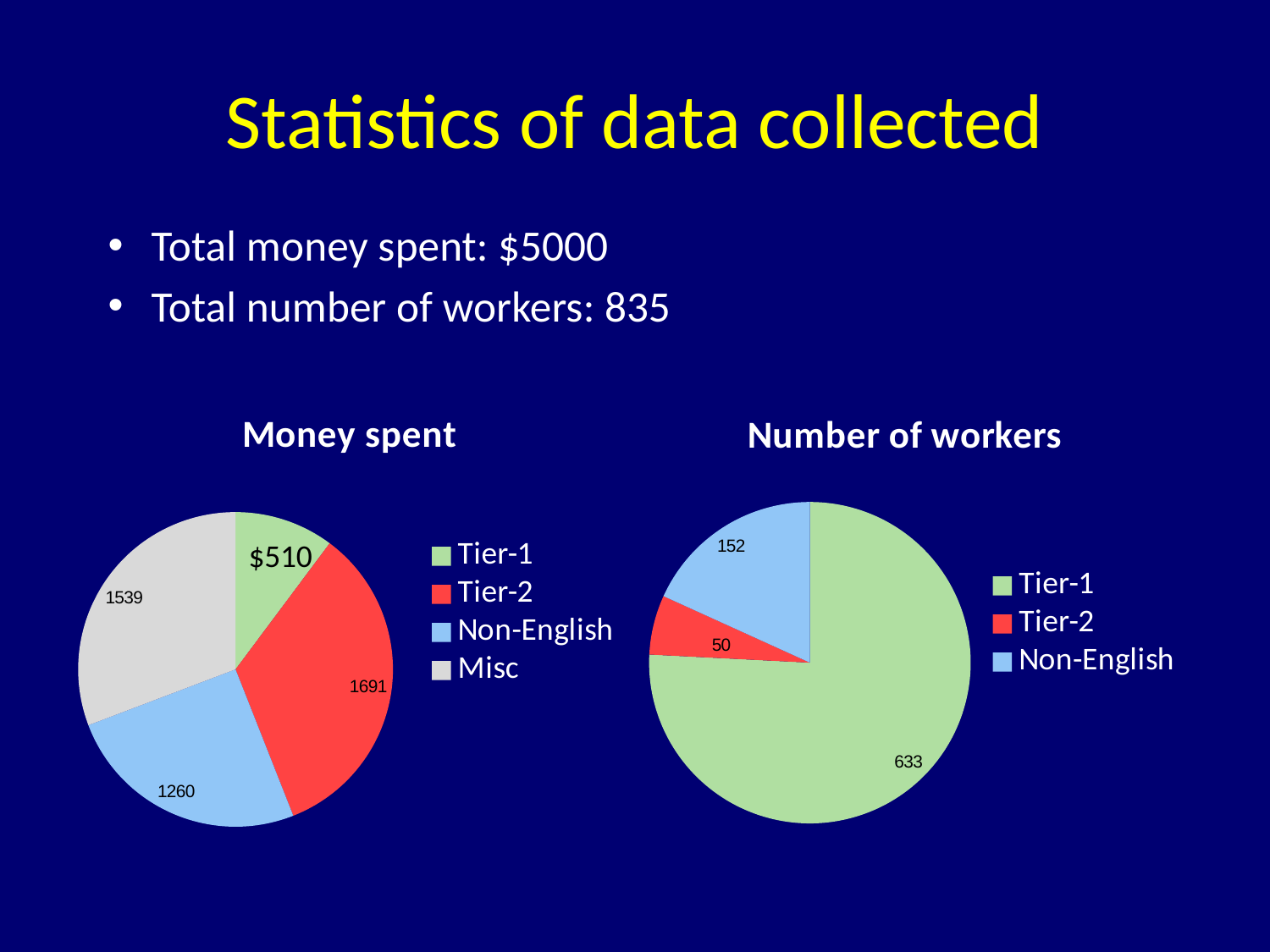
In the Money spent chart, what is the difference between Misc and Non-English? 279 In the Money spent chart, what is the value for Tier-1? $510 In the Number of workers chart, what is the value for Tier-2? 50 In the Money spent chart, what is the value for Tier-2? 1691 In the Money spent chart, which category has the smallest slice? Tier-1 What kind of chart is the Number of workers chart? Pie chart In the Money spent chart, which is larger, Misc or Non-English? Misc How many slices does the Money spent chart have? 4 In the Money spent chart, which category has the largest slice? Tier-2 In the Number of workers chart, which category has the largest slice? Tier-1 In the Number of workers chart, what is the value for Non-English? 152 In the Number of workers chart, what is the difference between Tier-1 and Non-English? 481